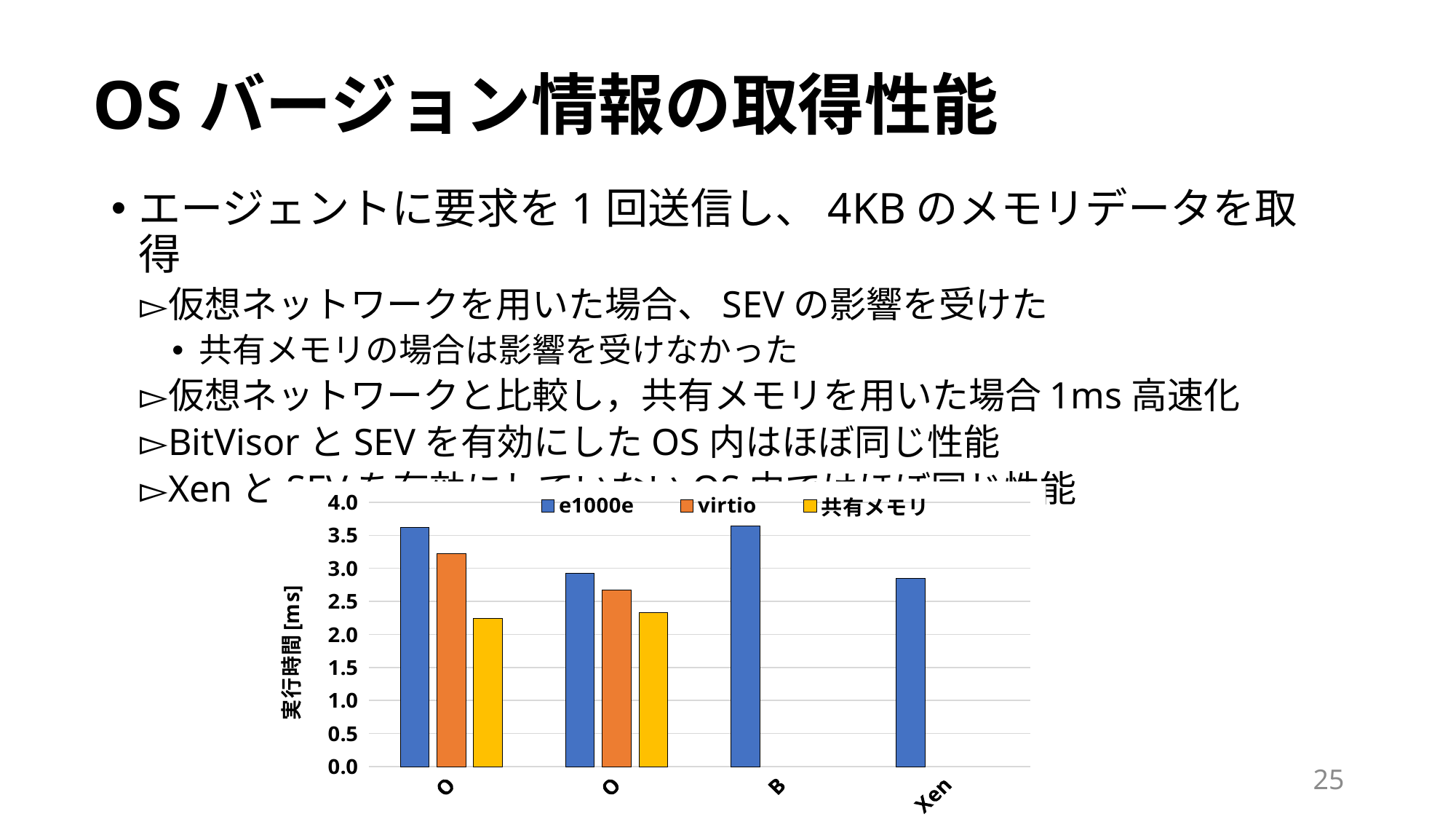
How many bars are plotted for the Xen category? 1 Is the e1000e value for Xen greater or less than 3.0? less How many series does the chart's legend list? 3 What are the three entries in the chart's legend? e1000e, virtio, 共有メモリ Is the e1000e value for Xen greater or less than 2.5? greater How many category groups are plotted along the x axis of the chart? 4 Which series has a bar plotted for the Xen category? e1000e What kind of chart is shown on the slide? bar chart What is the label of the chart's vertical axis? 実行時間 [ms]